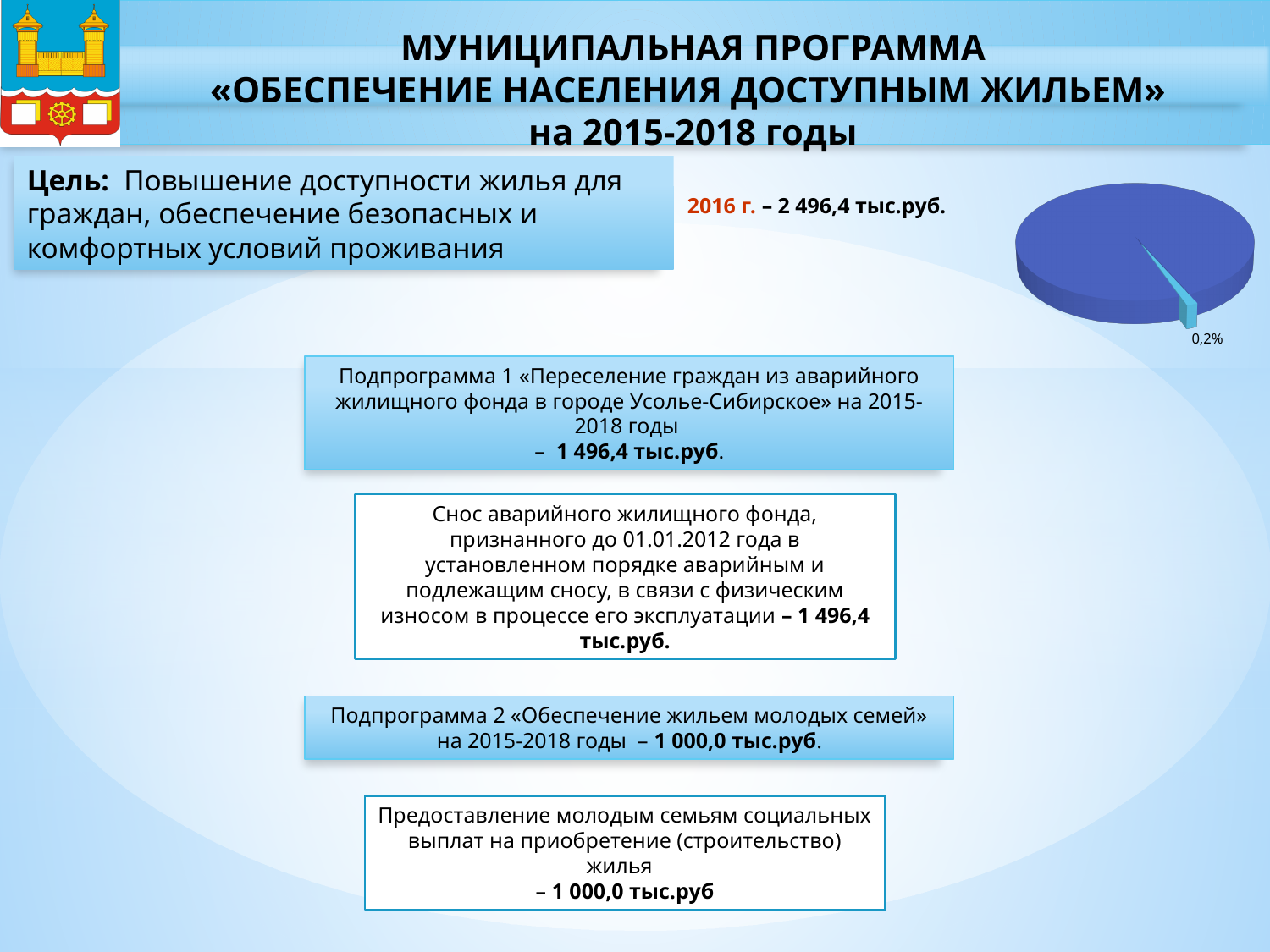
What kind of chart is shown on the slide? pie chart What percentage is printed as the data label on the small slice of the pie chart? 0,2% How many slices does the pie chart have? 2 How many data labels are printed on the pie chart? 1 Does the pie chart display a legend? No What share of the pie does the small light-blue slice represent? 0,2% Which slice of the pie chart is larger, the dark-blue slice or the small light-blue slice labelled 0,2%? the dark-blue slice